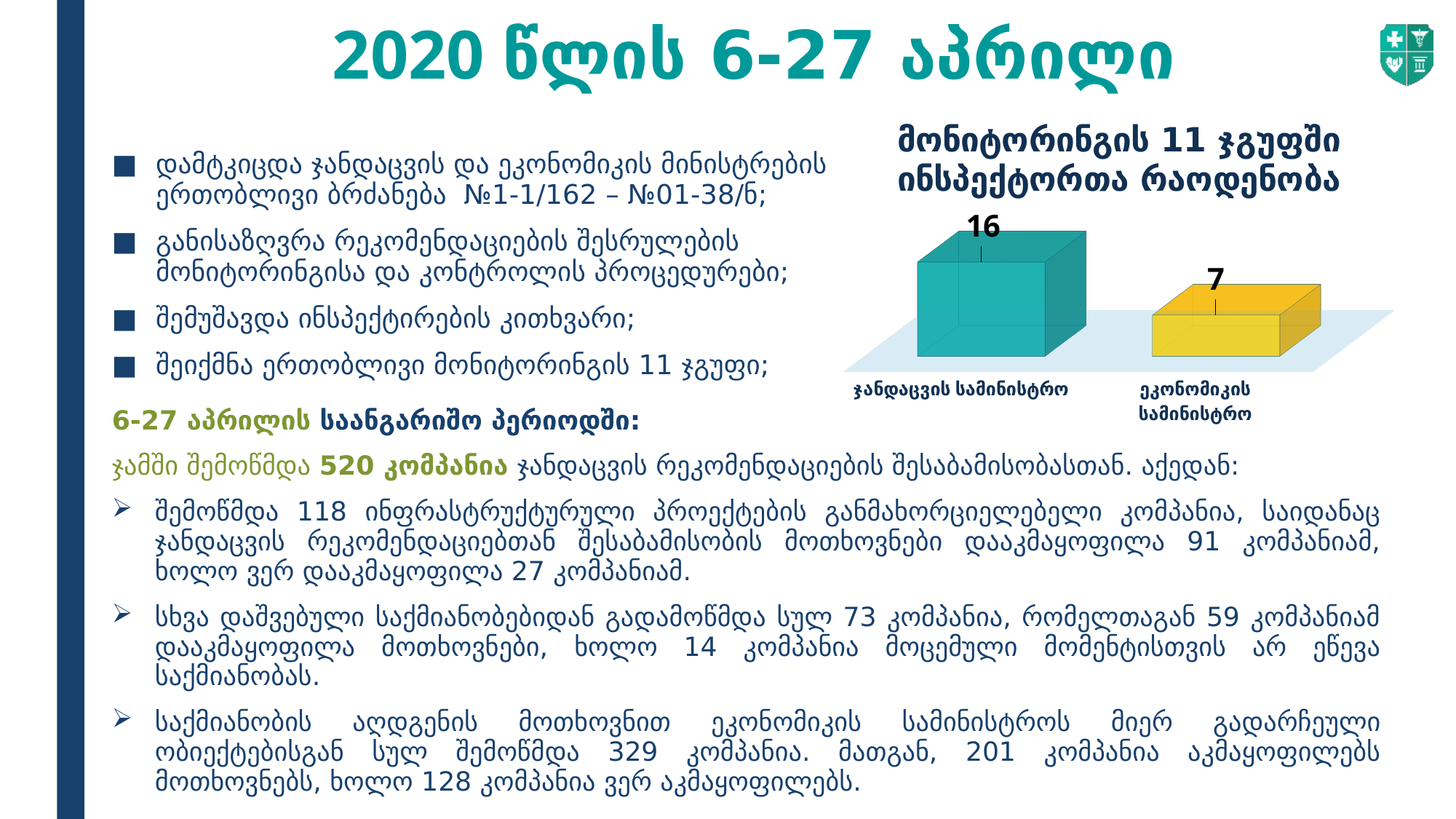
Which category has the highest value in the chart? ჯანდაცვის სამინისტრო What is the value for ეკონომიკის სამინისტრო in the chart? 7 Which is larger: the value for ჯანდაცვის სამინისტრო or the value for ეკონომიკის სამინისტრო? ჯანდაცვის სამინისტრო What is the difference between the values for ჯანდაცვის სამინისტრო and ეკონომიკის სამინისტრო? 9 Which category has the lowest value in the chart? ეკონომიკის სამინისტრო How many categories are shown in the chart? 2 What is the total of the two values shown in the chart? 23 What kind of chart is shown on the slide? bar chart What is the title of the chart? მონიტორინგის 11 ჯგუფში ინსპექტორთა რაოდენობა What colour is the bar for ეკონომიკის სამინისტრო? yellow What is the value for ჯანდაცვის სამინისტრო in the chart? 16